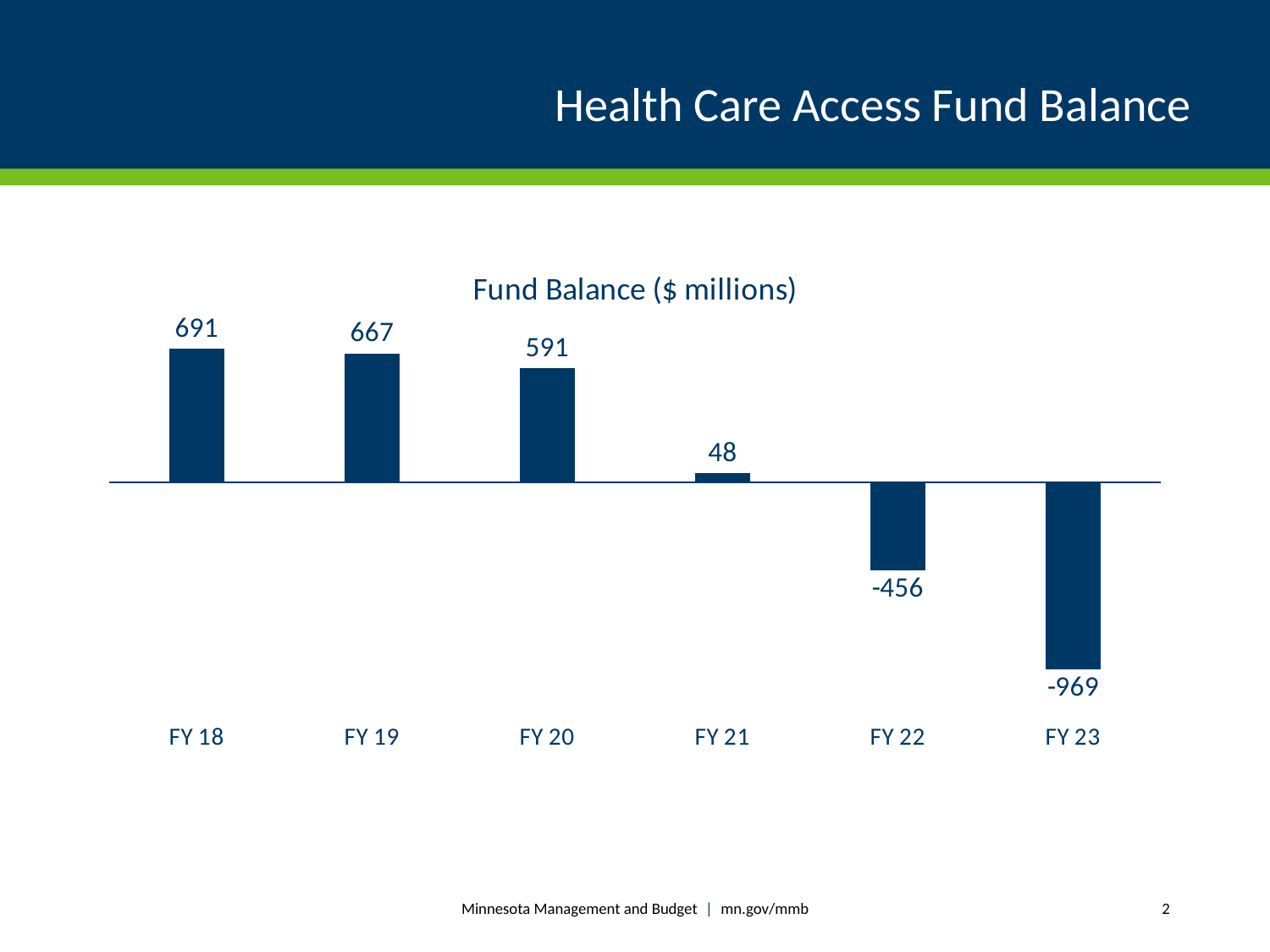
Does the fund balance rise or fall from FY 18 to FY 23? Fall What is the fund balance for FY 22? -456 What is the difference between the fund balance in FY 20 and FY 21? 543 What is the fund balance for FY 18? 691 Which fiscal year has the lowest fund balance? FY 23 What kind of chart is shown on the slide? Bar chart What is the fund balance for FY 21? 48 What is the fund balance for FY 23? -969 What is the difference between the fund balance in FY 18 and FY 19? 24 Which fiscal year has the highest fund balance? FY 18 Which is larger, the fund balance in FY 19 or FY 20? FY 19 How many fiscal years are shown in the chart? 6